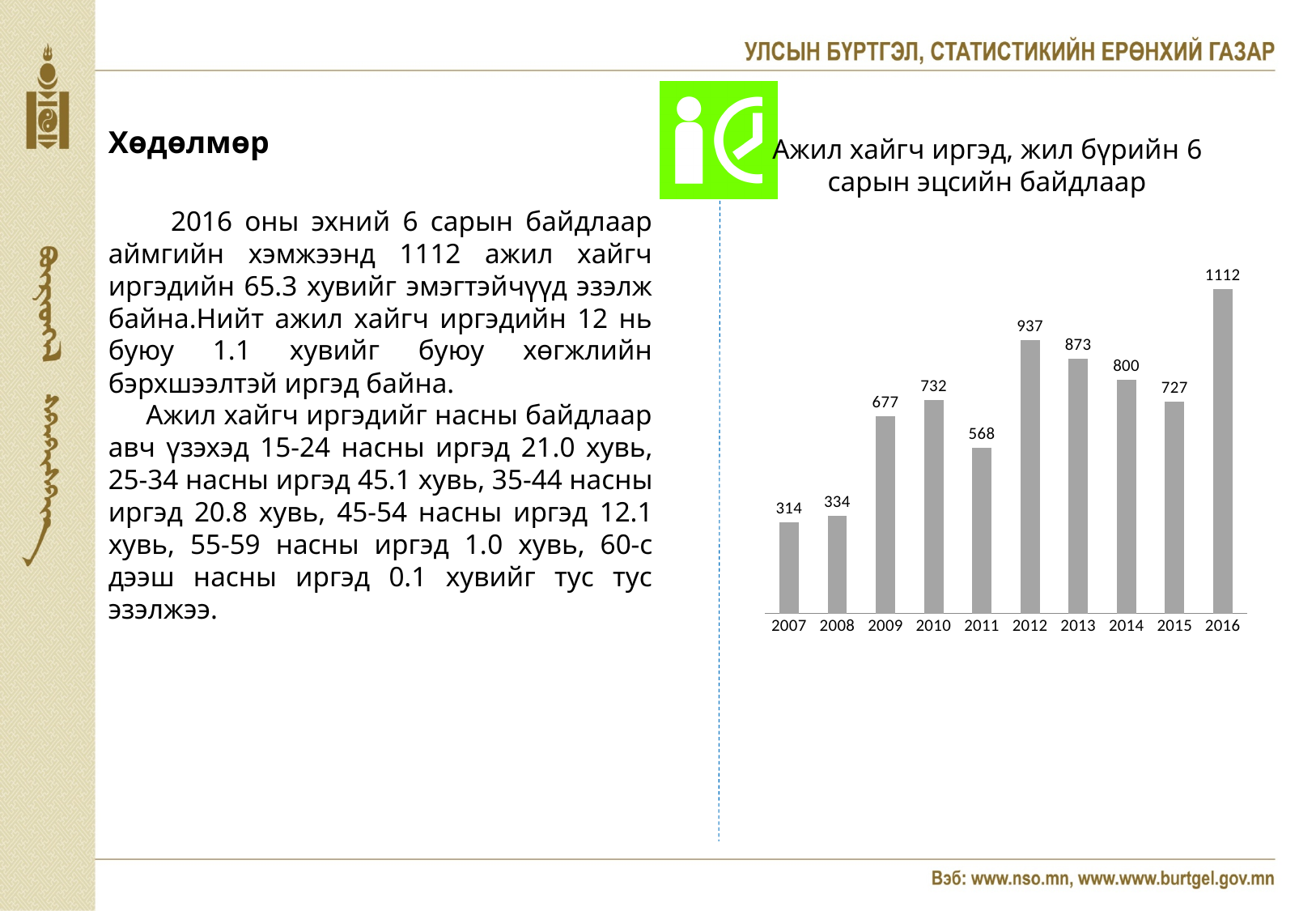
Which year has the highest value in the chart? 2016 How many years are shown on the x axis of the chart? 10 What is the value for 2011 in the chart? 568 What is the value for 2016 in the chart? 1112 What is the title of the chart? Ажил хайгч иргэд, жил бүрийн 6 сарын эцсийн байдлаар What is the difference between the values for 2016 and 2015? 385 Which year has the lowest value in the chart? 2007 What is the value for 2012 in the chart? 937 What is the difference between the values for 2012 and 2011? 369 Which is larger, the value for 2009 or the value for 2010? 2010 Which is larger, the value for 2013 or the value for 2014? 2013 What kind of chart is shown on the slide? bar chart